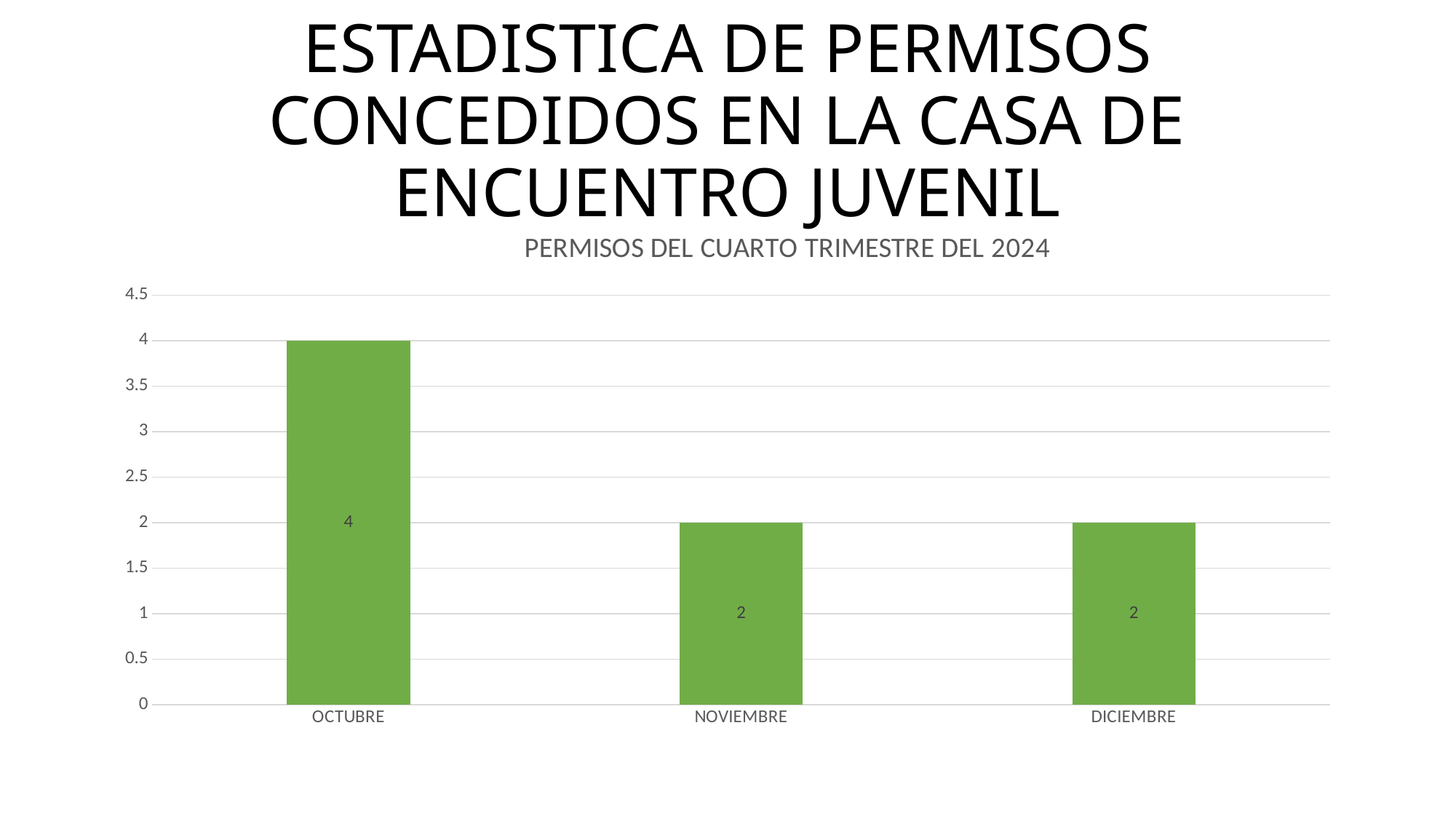
Is the value for OCTUBRE greater or less than 3? greater Is the value for NOVIEMBRE greater or less than 3? less What is the value for OCTUBRE? 4 What kind of chart is shown on the slide? bar chart How many months are shown on the x axis? 3 Which is larger, the value for OCTUBRE or the value for DICIEMBRE? OCTUBRE What is the value for DICIEMBRE? 2 What colour are the bars in the chart? green What is the title of the chart? PERMISOS DEL CUARTO TRIMESTRE DEL 2024 What is the difference between the values for OCTUBRE and NOVIEMBRE? 2 What is the value for NOVIEMBRE? 2 Which month has the highest value? OCTUBRE